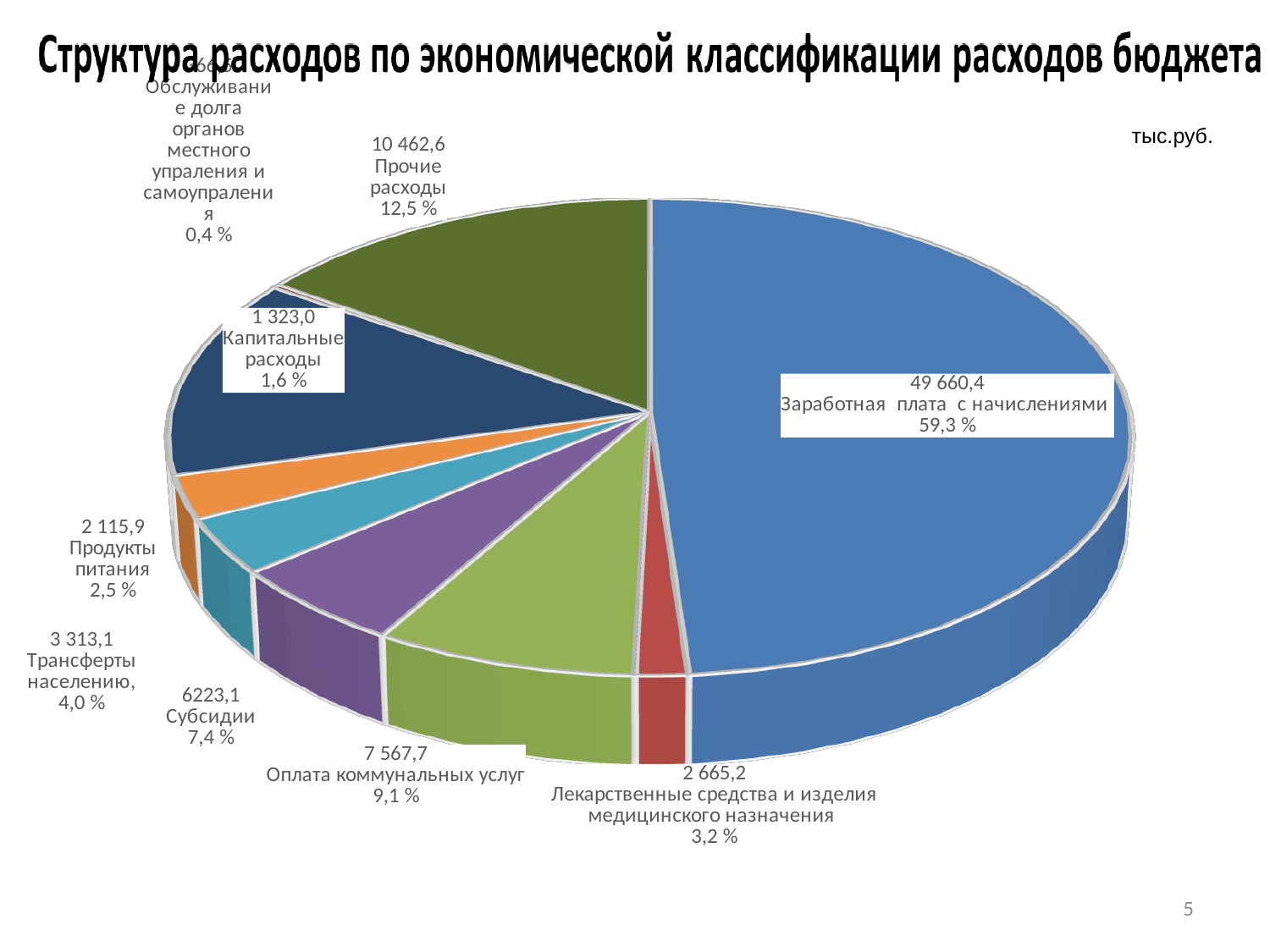
What is the difference between the values for Прочие расходы and Оплата коммунальных услуг? 2 894,9 What is the value for Заработная плата с начислениями? 49 660,4 What share of the pie does Субсидии represent? 7,4 % Which category has the largest slice of the pie? Заработная плата с начислениями What is the value for Прочие расходы? 10 462,6 What share of the pie does Трансферты населению represent? 4,0 % Which is larger: the value for Продукты питания or the value for Капитальные расходы? Продукты питания What kind of chart is shown on the slide? Pie chart Which category has the smallest slice of the pie? Обслуживание долга органов местного управления и самоуправления How many slices does the pie chart have? 9 What is the value for Лекарственные средства и изделия медицинского назначения? 2 665,2 What is the value for Оплата коммунальных услуг? 7 567,7